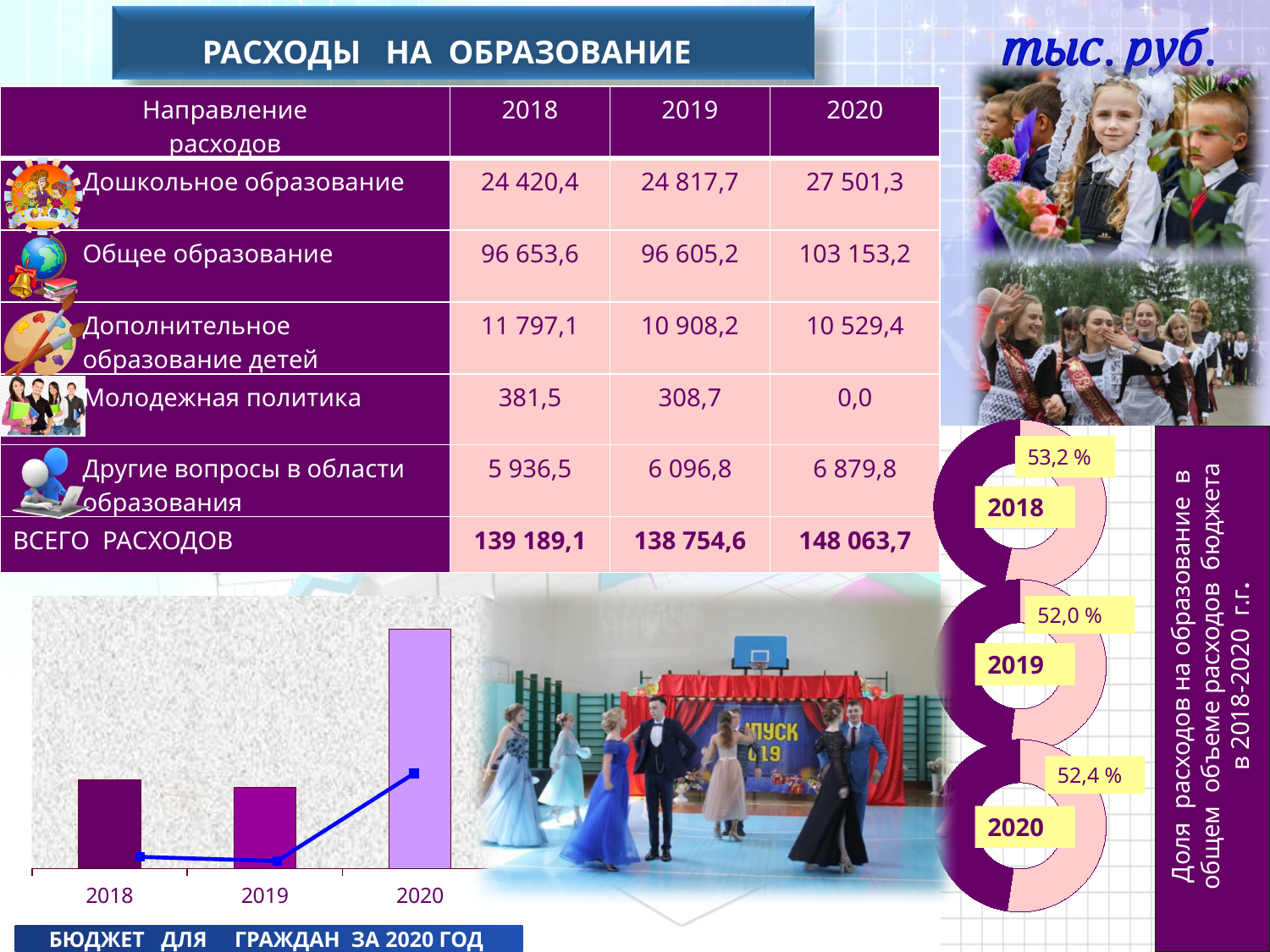
In the bar chart at the bottom left, is the bar for 2020 taller or shorter than the bar for 2018? taller In the donut charts on the right, which year has the lowest share of education spending? 2019 What kind of chart is the chart at the bottom left of the slide? bar chart In the donut charts on the right (share of education spending in total budget spending), what is the value for 2019? 52,0 % How many years are shown on the x axis of the bar chart at the bottom left? 3 In the bar chart at the bottom left, which years are shown as categories? 2018, 2019, 2020 In the donut charts on the right, is the share for 2020 greater or less than the share for 2019? greater In the donut charts on the right, which year has the highest share of education spending? 2018 In the bar chart at the bottom left, which year has the tallest bar? 2020 In the donut charts on the right, by how many percentage points does the 2018 share exceed the 2019 share? 1,2 In the donut charts on the right (share of education spending in total budget spending), what is the value for 2018? 53,2 % In the donut charts on the right (share of education spending in total budget spending), what is the value for 2020? 52,4 %